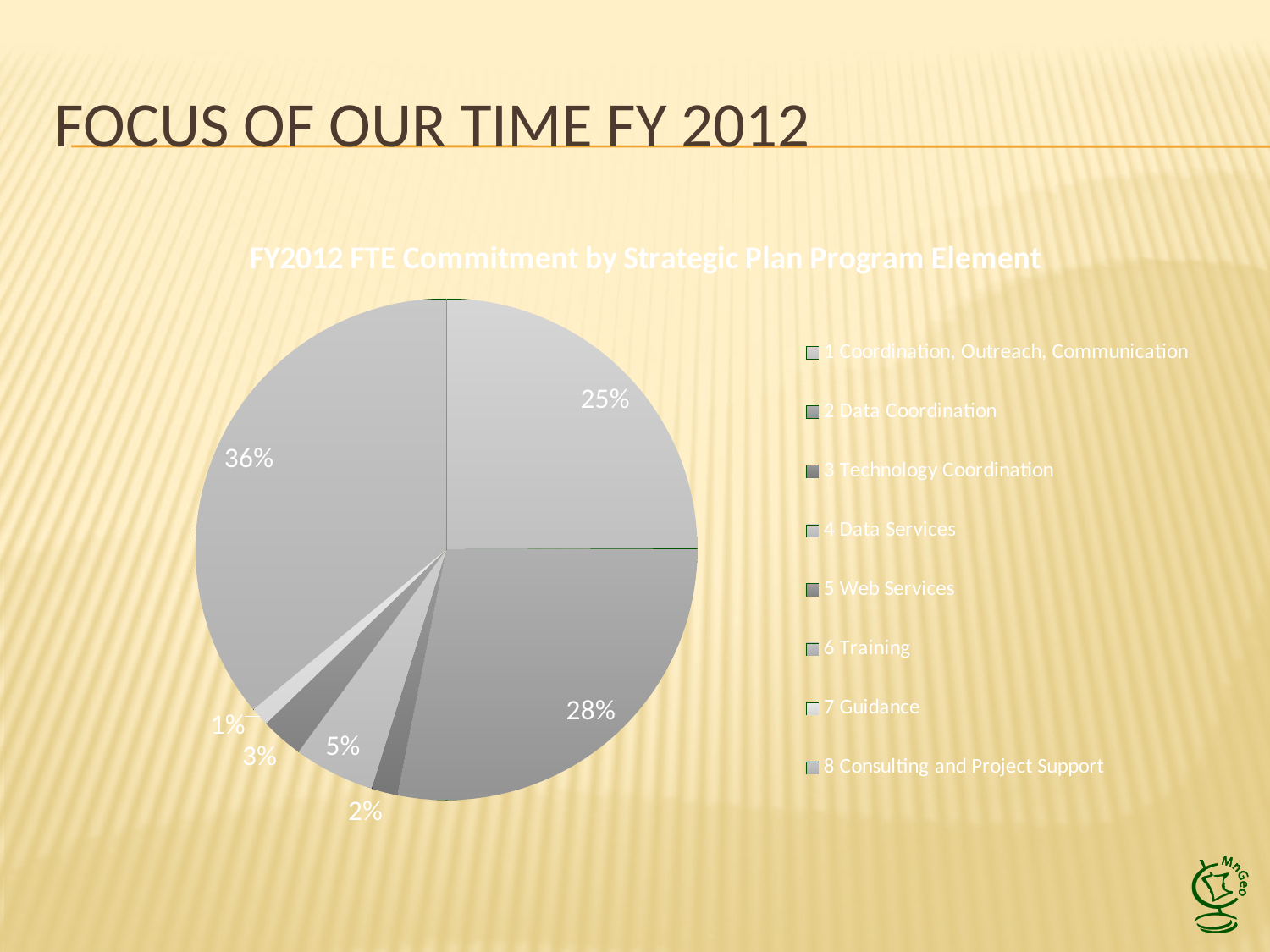
Is the largest slice of the pie greater or less than 30%? greater What is the value of the largest slice of the pie? 36% What is the combined share of the slices labelled 5%, 3%, 2% and 1%? 11% What is the difference between the largest slice (36%) and the second-largest slice (28%)? 8 percentage points What is the combined share of the two largest slices, 36% and 28%? 64% What is the title of the chart? FY2012 FTE Commitment by Strategic Plan Program Element What kind of chart is shown on the slide? pie chart Which is larger, the slice labelled 25% or the slice labelled 28%? 28% How many entries does the chart's legend list? 8 What is the value of the smallest labelled slice of the pie? 1% Which legend entry is listed first? 1 Coordination, Outreach, Communication How many percentage data labels are printed on the pie? 7